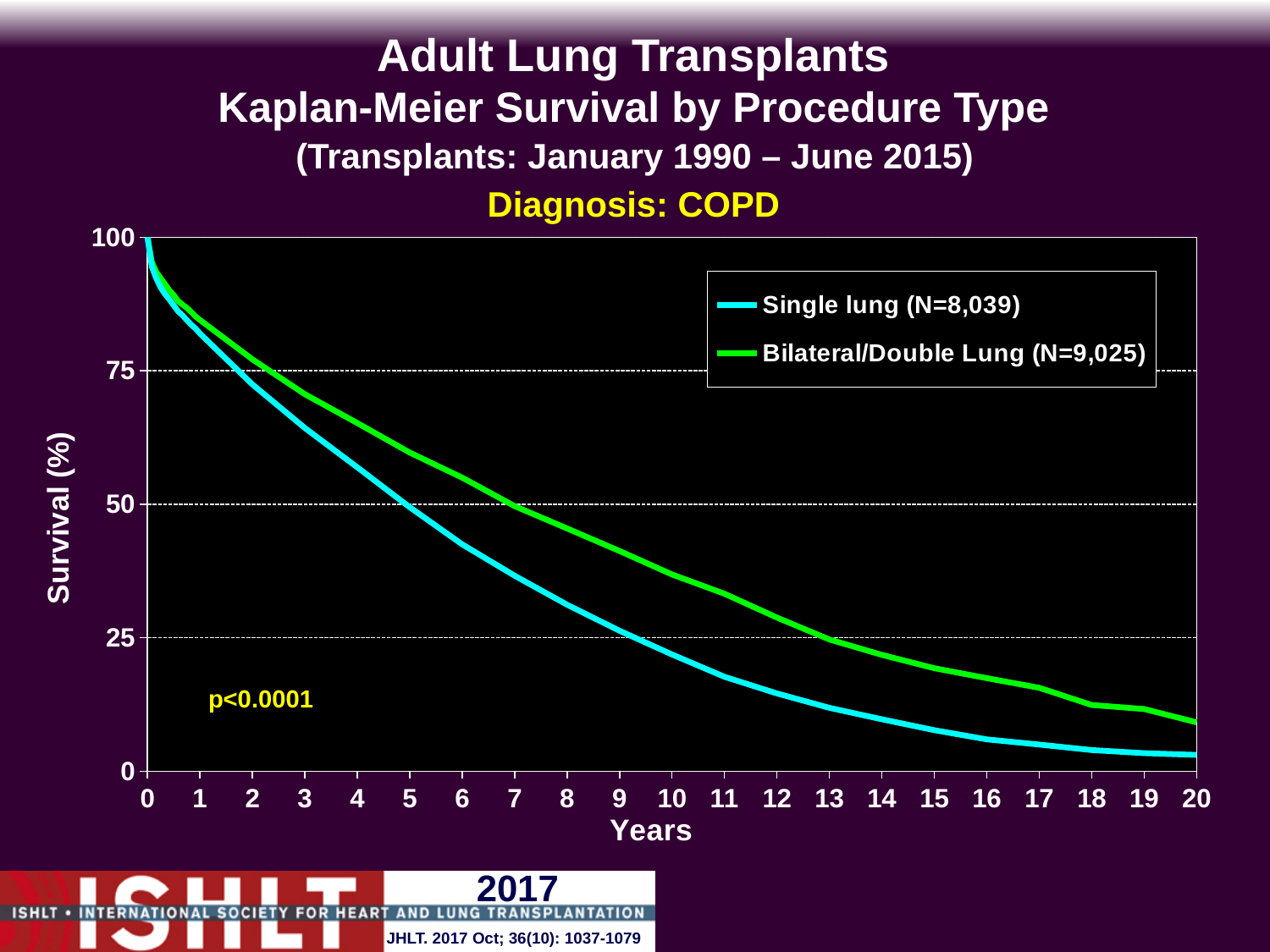
At 10 years, which procedure type has the higher survival, Single lung or Bilateral/Double Lung? Bilateral/Double Lung What is the number of patients (N) in the Single lung group according to the legend? 8,039 What kind of chart is shown on the slide? line chart Is the survival for Bilateral/Double Lung at 20 years greater or less than 25? less Is the survival for Single lung at 10 years greater or less than 50? less Is the survival for Bilateral/Double Lung at 10 years greater or less than 25? greater Do the survival curves rise or fall as years since transplant increase? fall How many series does the legend list? 2 What p-value is shown on the chart? p<0.0001